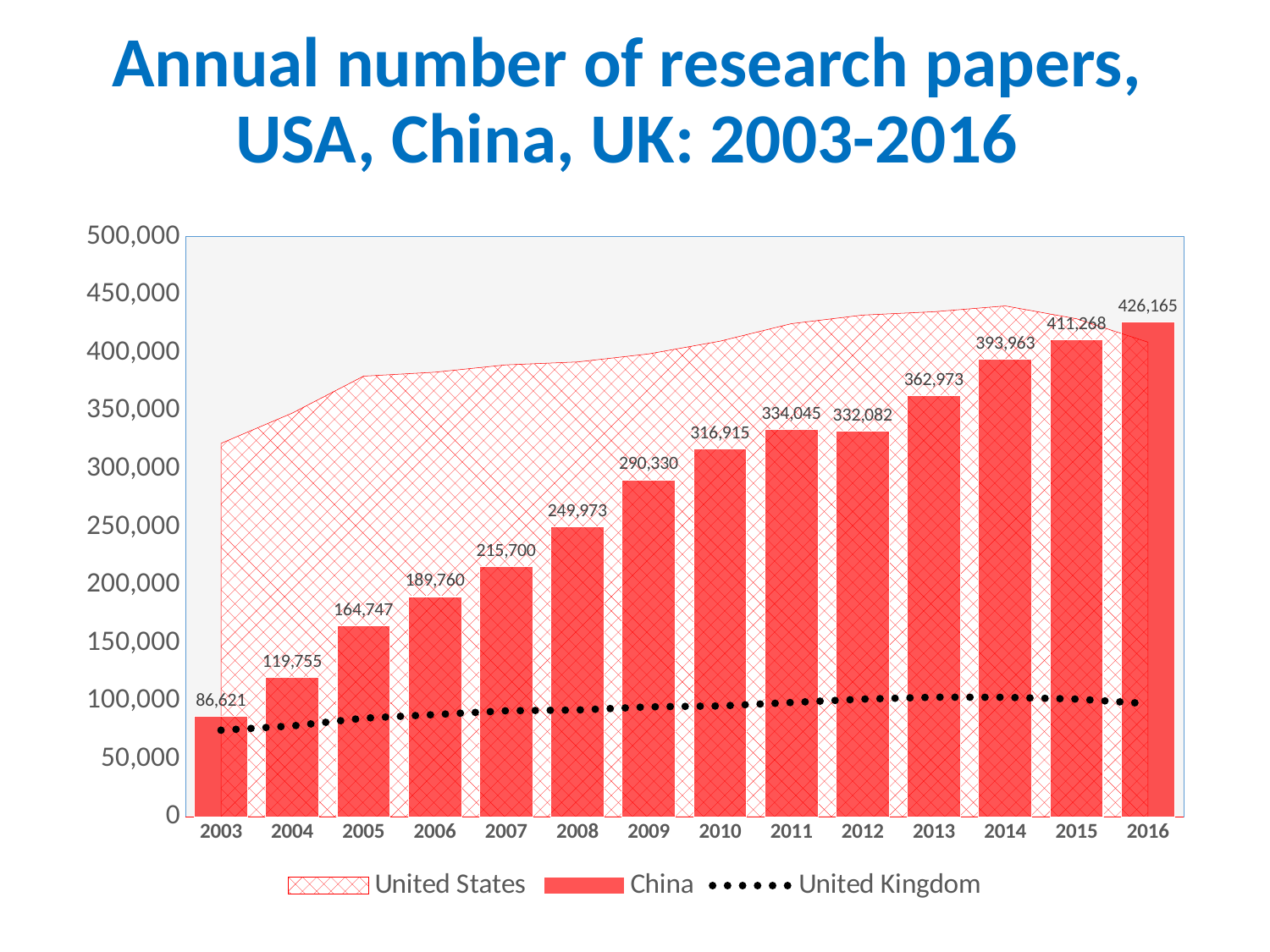
How many years are shown on the x axis? 14 In which year is the China value highest? 2016 Which is larger, the China value for 2011 or for 2012? 2011 Is the value for the United Kingdom in 2003 greater or less than 100,000? less What is the value for China in 2009? 290,330 How many series does the legend list? 3 In which year is the China value lowest? 2003 What is the value for China in 2016? 426,165 What is the value for China in 2003? 86,621 Do the China values generally rise or fall from 2003 to 2016? rise What is the difference between the China values for 2016 and 2003? 339,544 Is the value for the United States in 2003 greater or less than 300,000? greater